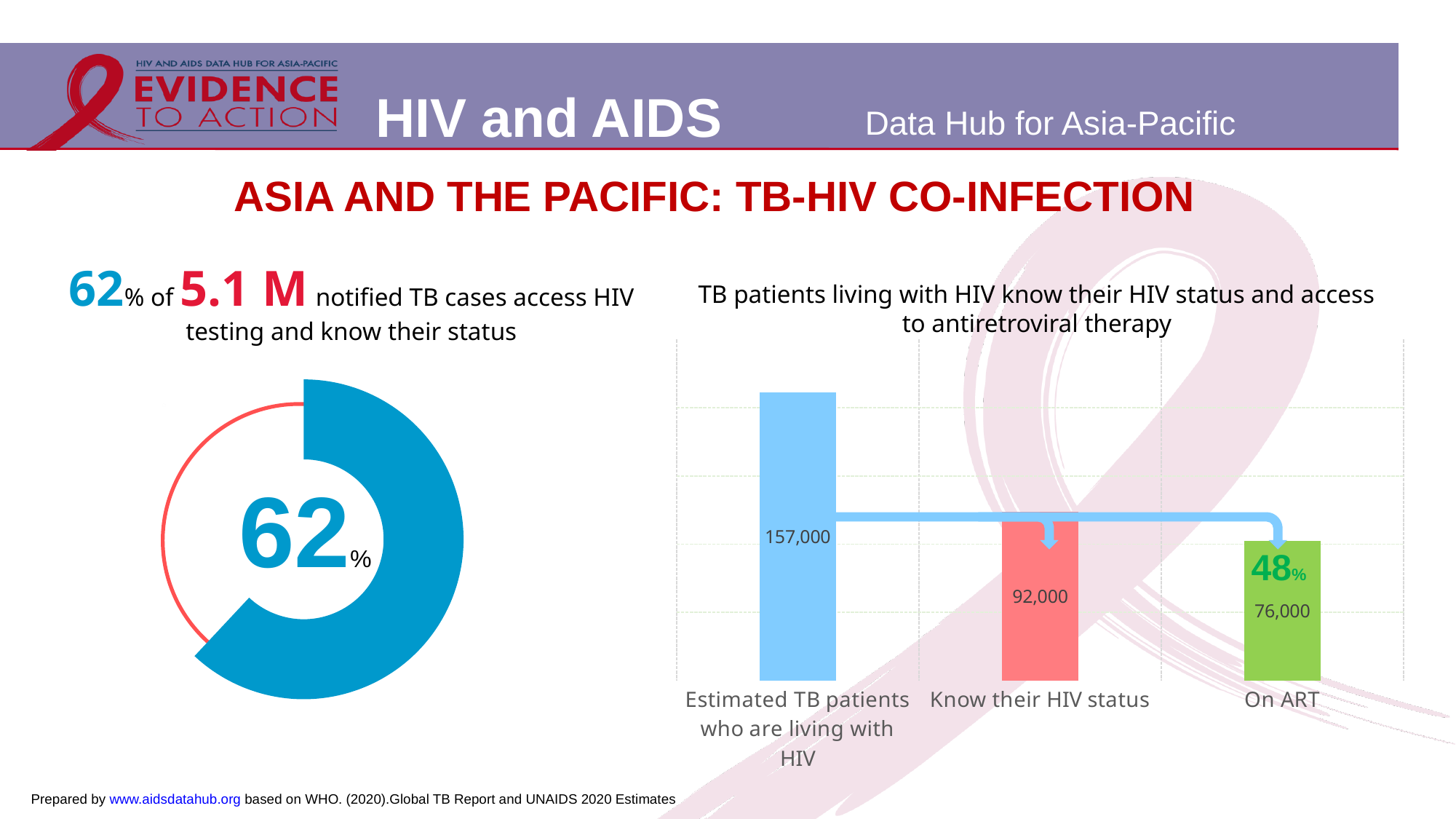
How many categories are shown in the bar chart on the right? 3 In the bar chart on the right, which is larger: 'Know their HIV status' or 'On ART'? Know their HIV status In the bar chart on the right, what is the value for 'Estimated TB patients who are living with HIV'? 157,000 In the bar chart on the right, what is the difference between 'Estimated TB patients who are living with HIV' and 'Know their HIV status'? 65,000 In the bar chart on the right, which category has the lowest value? On ART In the bar chart on the right, what percentage is printed on the 'On ART' bar? 48% What kind of chart is on the left side of the slide? Donut chart In the bar chart on the right, which category has the highest value? Estimated TB patients who are living with HIV In the bar chart on the right, what is the value for 'Know their HIV status'? 92,000 What percentage is shown in the centre of the donut chart on the left? 62% In the bar chart on the right, what is the value for 'On ART'? 76,000 In the bar chart on the right, what is the difference between 'Know their HIV status' and 'On ART'? 16,000